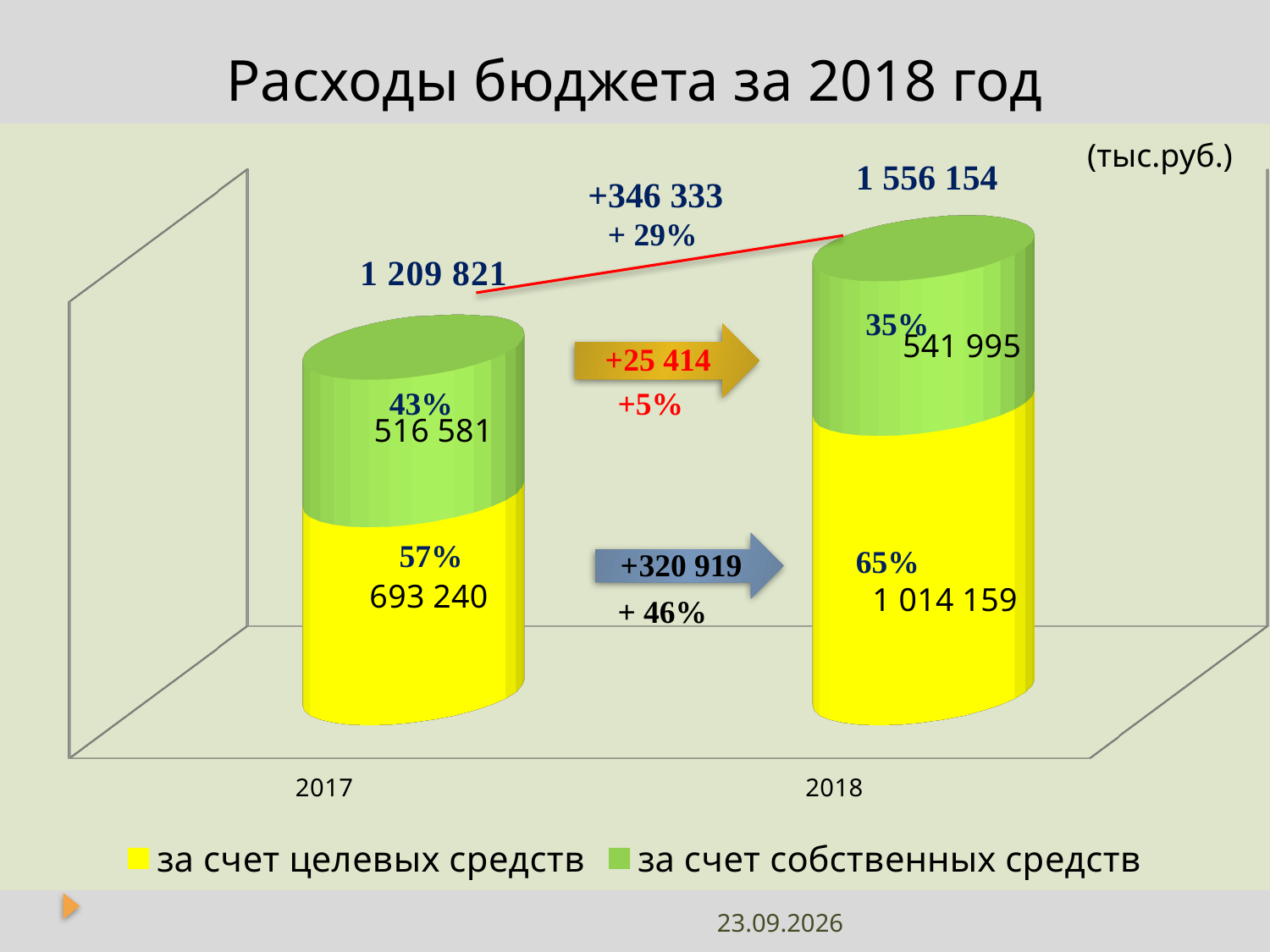
What kind of chart is shown on the slide? Stacked bar chart What is the difference between the "за счет целевых средств" values for 2018 and 2017? 320 919 What is the difference between the "за счет собственных средств" values for 2018 and 2017? 25 414 What is the total of the stacked bar for 2018? 1 556 154 What is the value for "за счет собственных средств" in 2018? 541 995 What is the value for "за счет целевых средств" in 2018? 1 014 159 What is the value for "за счет целевых средств" in 2017? 693 240 How many series does the legend list? 2 How many categories are shown on the x axis? 2 What is the value for "за счет собственных средств" in 2017? 516 581 What is the total of the stacked bar for 2017? 1 209 821 Which is larger in 2018: "за счет целевых средств" or "за счет собственных средств"? за счет целевых средств